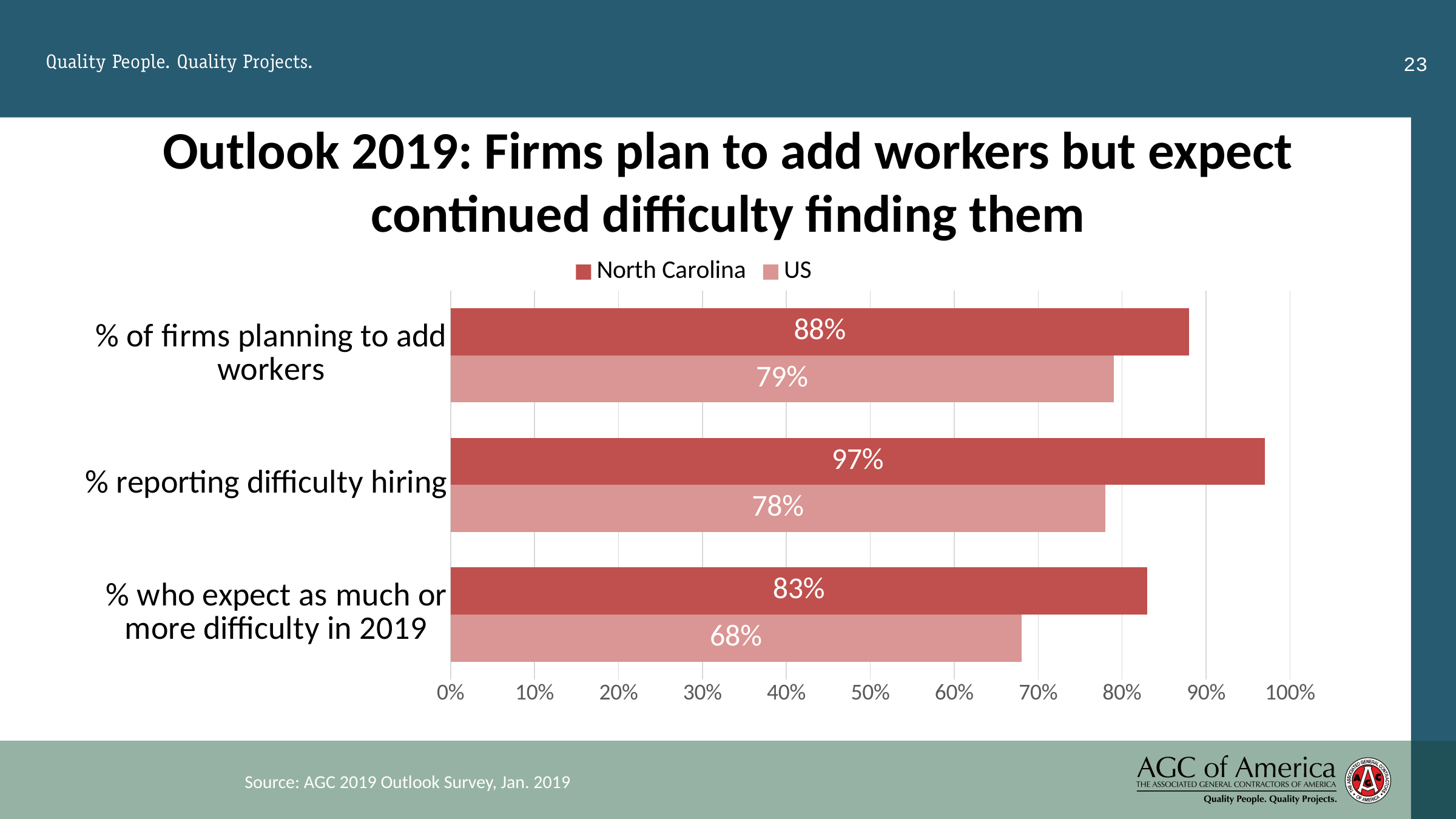
What is the difference between the North Carolina and US values for % reporting difficulty hiring? 19% What is the difference between the North Carolina and US values for % of firms planning to add workers? 9% What is the US value for % who expect as much or more difficulty in 2019? 68% What kind of chart is shown on the slide? Bar chart Which is larger for % who expect as much or more difficulty in 2019: North Carolina or US? North Carolina What is the US value for % reporting difficulty hiring? 78% Which category has the highest North Carolina value? % reporting difficulty hiring How many categories are shown on the chart? 3 What percentage of North Carolina firms are planning to add workers? 88% Which category has the lowest US value? % who expect as much or more difficulty in 2019 How many series does the legend list? 2 What is the source cited for the chart? AGC 2019 Outlook Survey, Jan. 2019